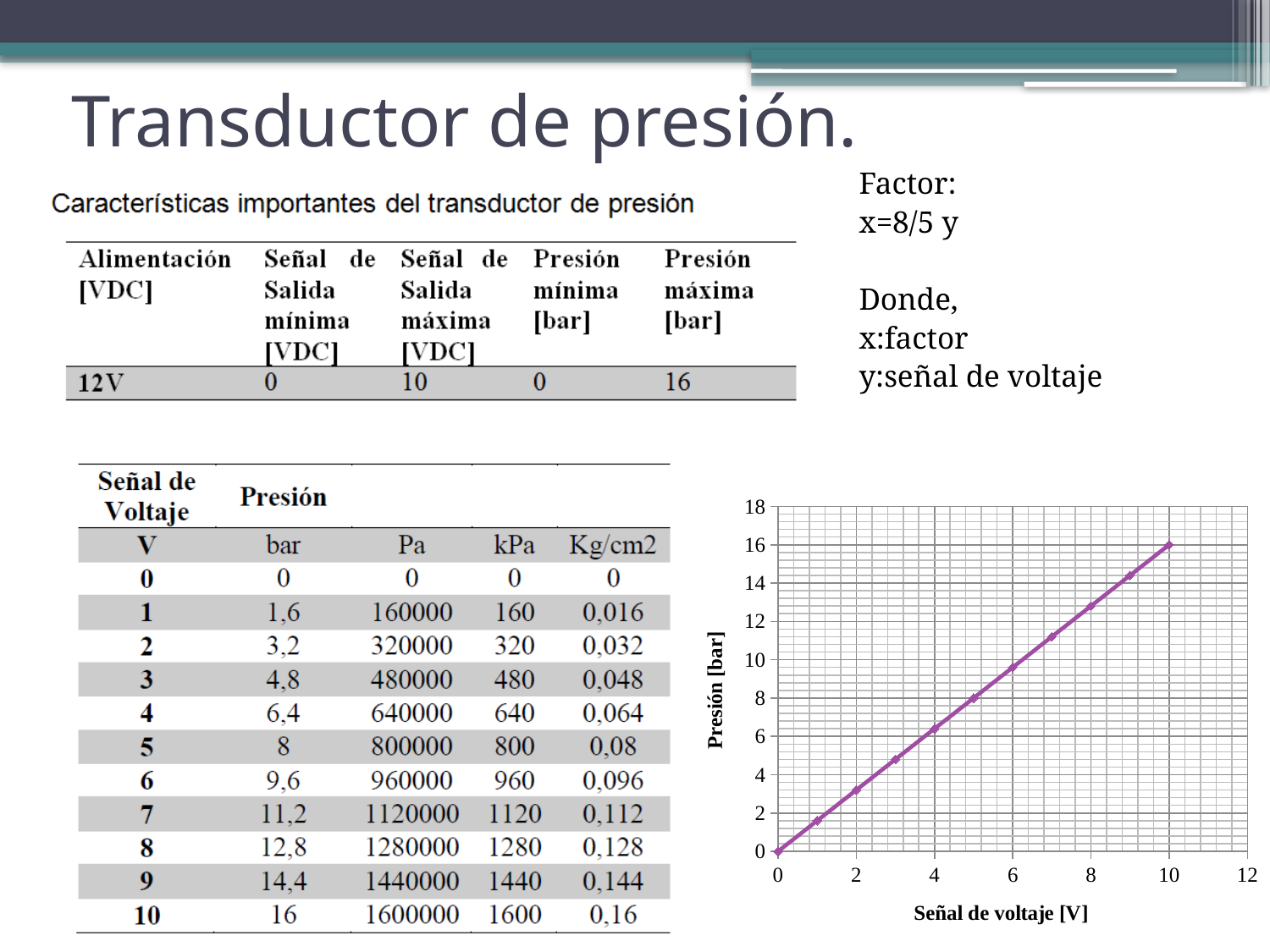
What is the pressure value plotted at a voltage signal of 10 V? 16 What is the title of the x axis of the chart? Señal de voltaje [V] What kind of chart is shown on the slide? line chart What is the title of the y axis of the chart? Presión [bar] Is the pressure value at a voltage signal of 7 V greater or less than 10? greater Is the pressure value at a voltage signal of 3 V greater or less than 6? less Which has the larger plotted pressure: a voltage signal of 8 V or 3 V? 8 V At which voltage signal is the plotted pressure highest? 10 Does the pressure rise or fall as the voltage signal increases along the x axis? rises How many data points are plotted on the chart? 11 What is the pressure value plotted at a voltage signal of 5 V? 8 At which voltage signal is the plotted pressure lowest? 0